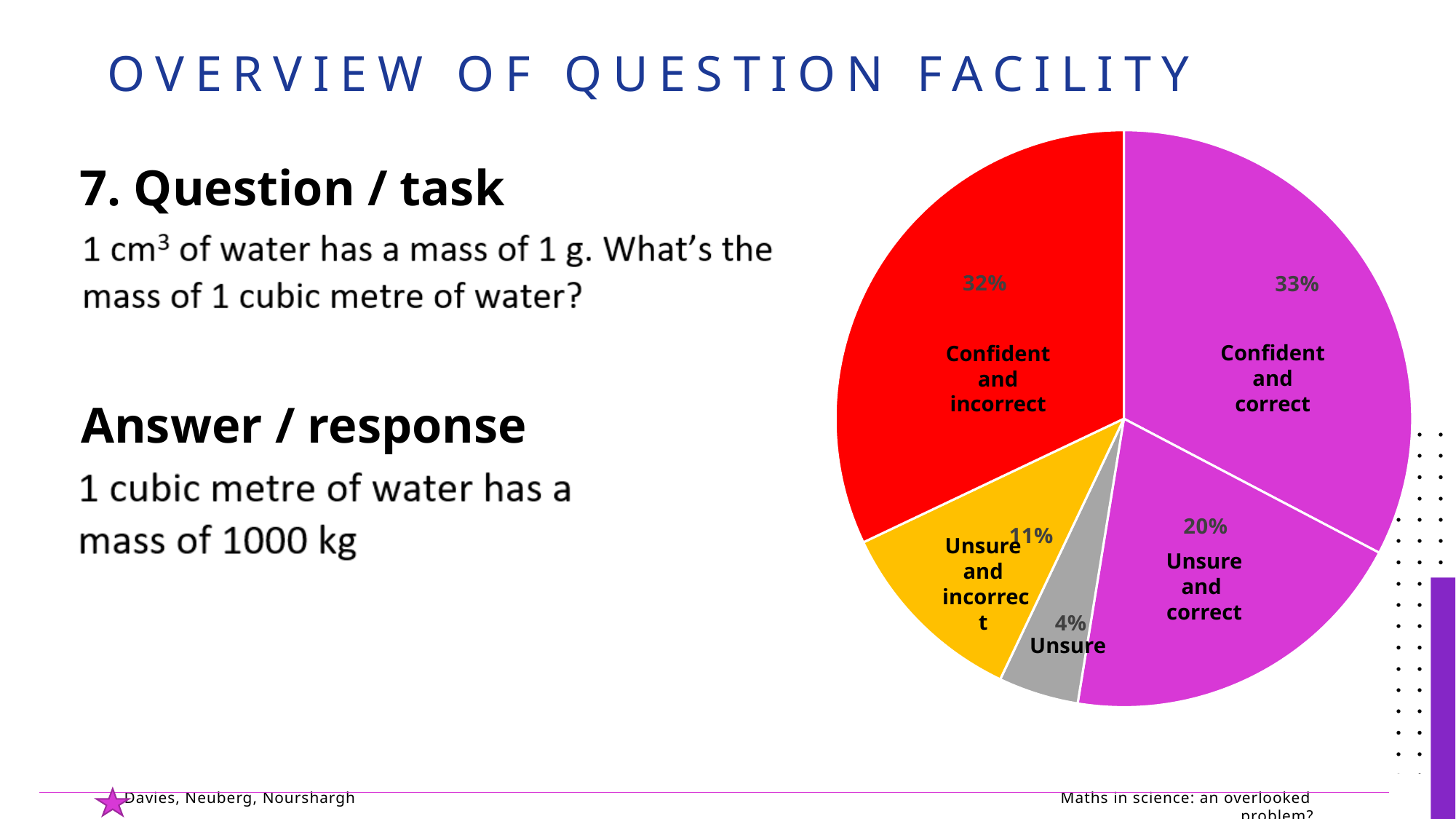
Which slice of the pie chart is the largest? Confident and correct How many slices does the pie chart have? 5 What colour is the 'Confident and incorrect' slice? red What kind of chart is shown on the slide? pie chart Which is larger: 'Confident and incorrect' or 'Unsure and correct'? Confident and incorrect What percentage of responses were 'Confident and correct'? 33% What percentage of responses were 'Unsure and incorrect'? 11% Which slice of the pie chart is the smallest? Unsure What percentage of responses were 'Unsure'? 4% What is the difference in percentage points between 'Unsure and correct' and 'Unsure and incorrect'? 9 What percentage of responses were 'Confident and incorrect'? 32% What percentage of responses were 'Unsure and correct'? 20%